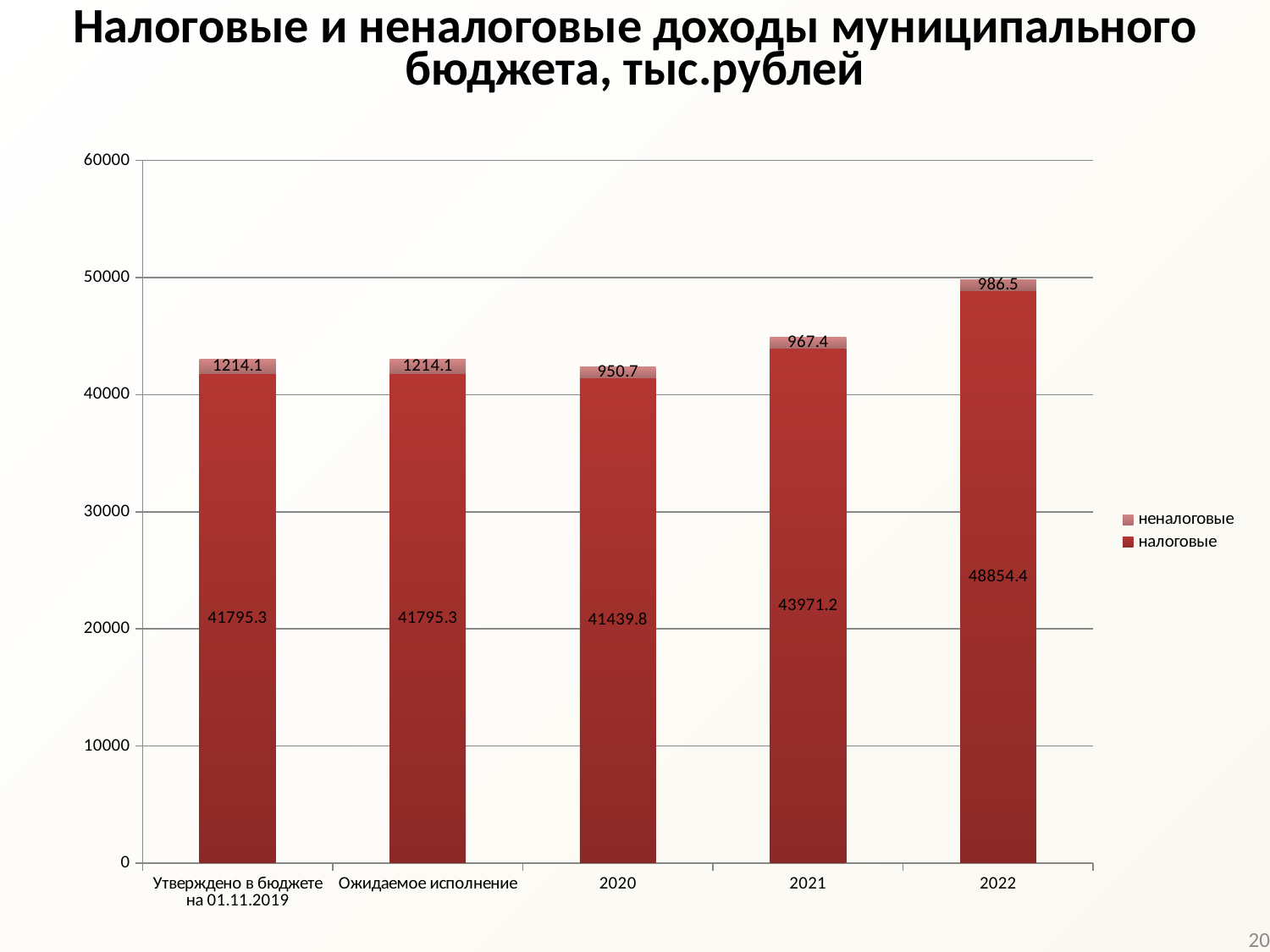
Which is larger, the неналоговые value for 2021 or for 2022? 2022 What is the value of налоговые for Ожидаемое исполнение? 41795.3 What is the value of неналоговые for 2020? 950.7 Which category has the highest налоговые value? 2022 What kind of chart is shown on the slide? Stacked bar chart How many series does the legend list? 2 What is the difference between the налоговые values for 2022 and 2021? 4883.2 Which category has the lowest налоговые value? 2020 What is the value of налоговые for 2022? 48854.4 What is the total of the stacked bar for 2022? 49840.9 What is the difference between the неналоговые values for 2022 and 2020? 35.8 How many categories are shown on the x axis? 5